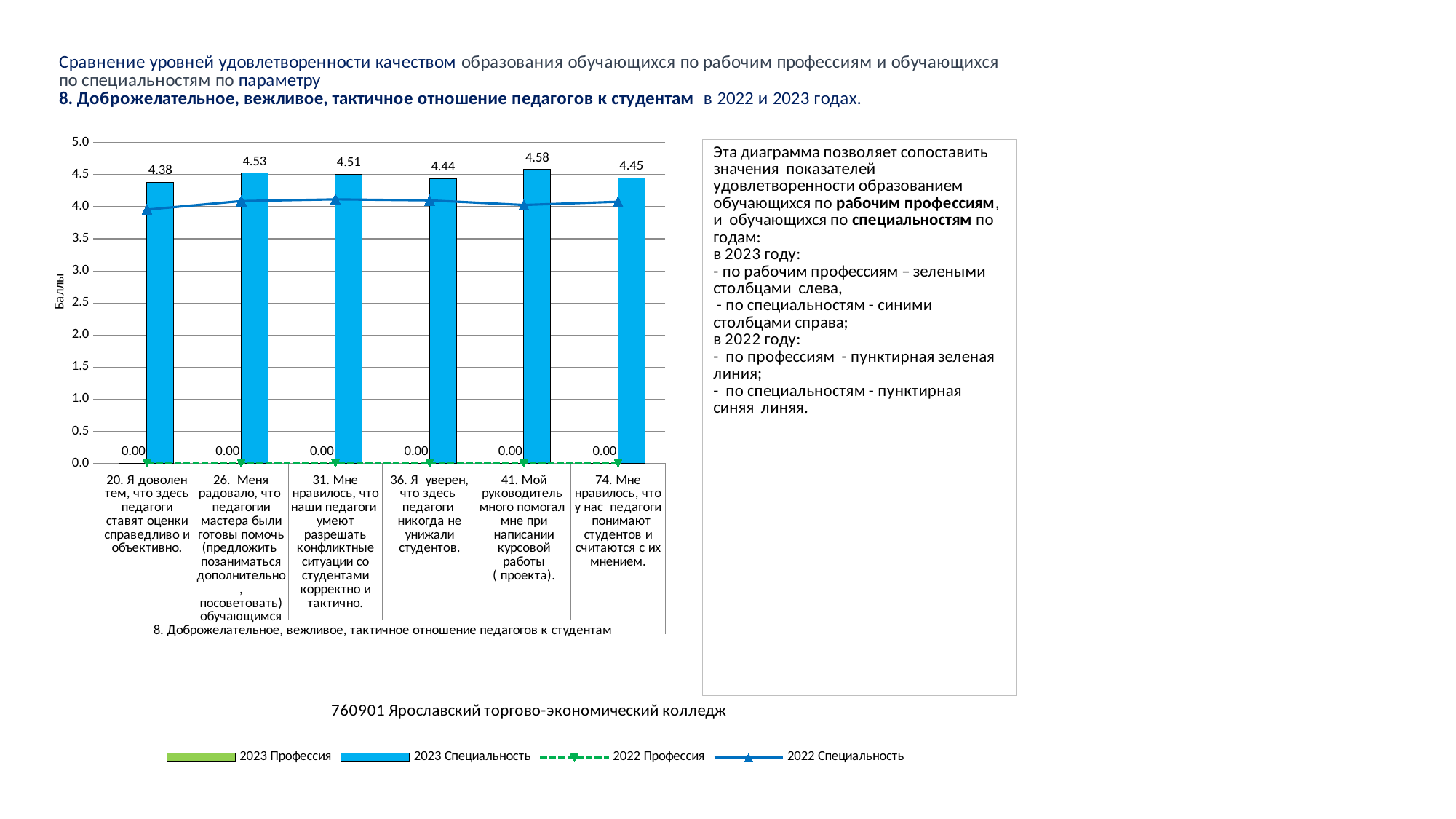
Which category has the highest value in the 2023 Специальность series? 41. Мой руководитель много помогал мне при написании курсовой работы ( проекта). What is the difference between the 2023 Специальность values for category 41 and category 20? 0.20 What is the value of the 2023 Специальность series for category "20. Я доволен тем, что здесь педагоги ставят оценки справедливо и объективно."? 4.38 Is the 2022 Специальность value for category 31 greater or less than 3.5? greater How many series does the chart legend list? 4 What is the value of the 2023 Специальность series for category "36. Я уверен, что здесь педагоги никогда не унижали студентов."? 4.44 Which is larger in the 2023 Специальность series: the value for category 26 or the value for category 74? 26. Меня радовало, что педагогии мастера были готовы помочь (предложить позаниматься дополнительно, посоветовать) обучающимся What is the label of the vertical axis of the chart? Баллы How many categories are shown on the x axis of the chart? 6 Which category has the lowest value in the 2023 Специальность series? 20. Я доволен тем, что здесь педагоги ставят оценки справедливо и объективно. What is the value of the 2023 Специальность series for category "41. Мой руководитель много помогал мне при написании курсовой работы ( проекта)."? 4.58 What is the value of the 2023 Профессия series for category "74. Мне нравилось, что у нас педагоги понимают студентов и считаются с их мнением."? 0.00